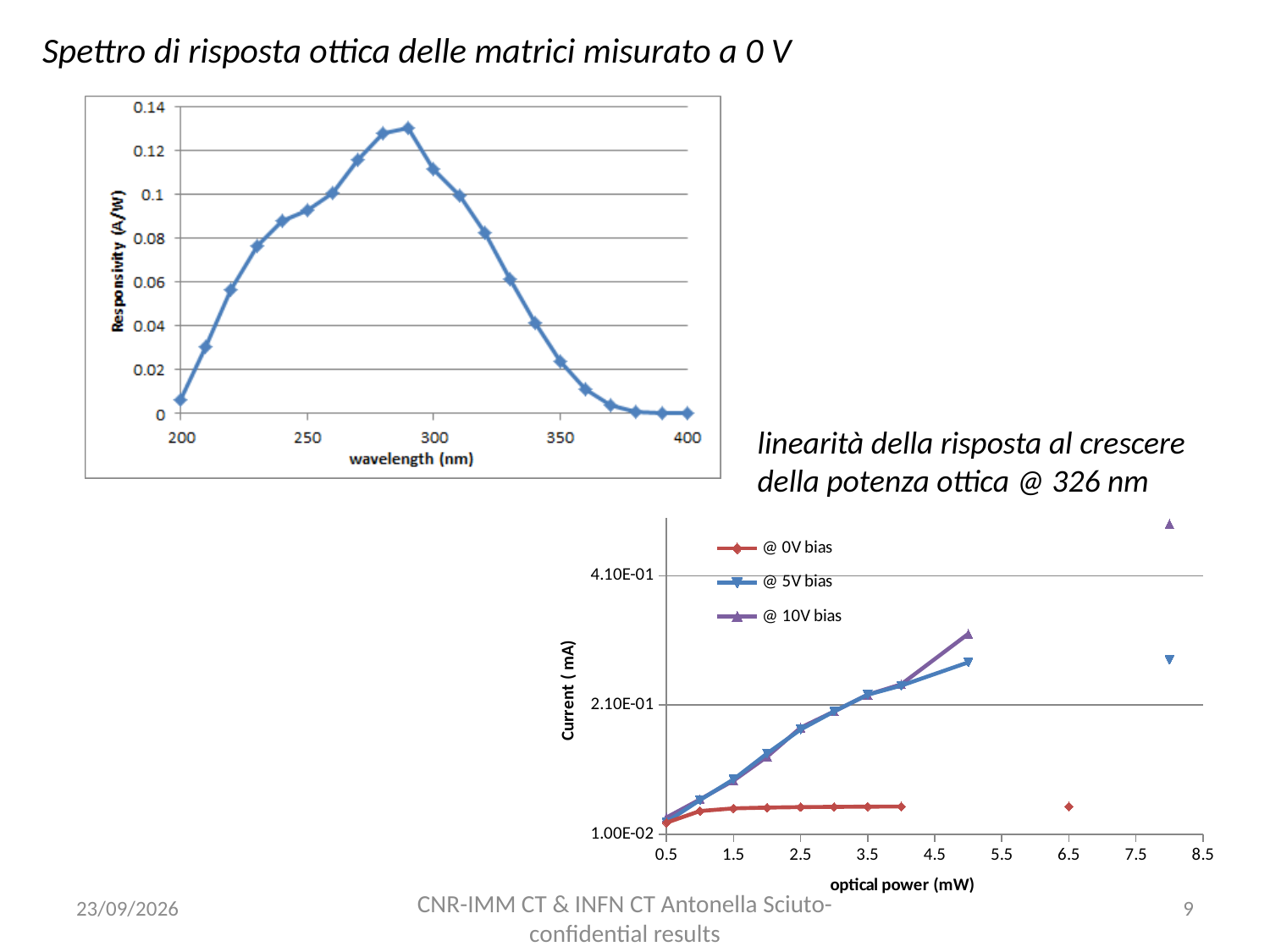
On the top-left chart, is the responsivity at 200 nm greater or less than 0.02? less On the top-left chart, how many data points are plotted? 21 On the top-left chart, does the responsivity rise or fall as the wavelength increases from 300 nm to 400 nm? fall On the top-left chart, is the responsivity at 350 nm greater or less than 0.04? less On the top-left chart, does the responsivity rise or fall as the wavelength increases from 200 nm to 290 nm? rise On the top-left chart, what kind of chart is shown? line chart On the bottom-right chart, is the current for @ 0V bias at 6.5 mW greater or less than 2.10E-01? less On the bottom-right chart, how many series does the legend list? 3 On the bottom-right chart, at 8 mW optical power, which series has the highest current? @ 10V bias On the bottom-right chart, what is the label of the x axis? optical power (mW) On the top-left chart, what is the label of the y axis? Responsivity (A/W)